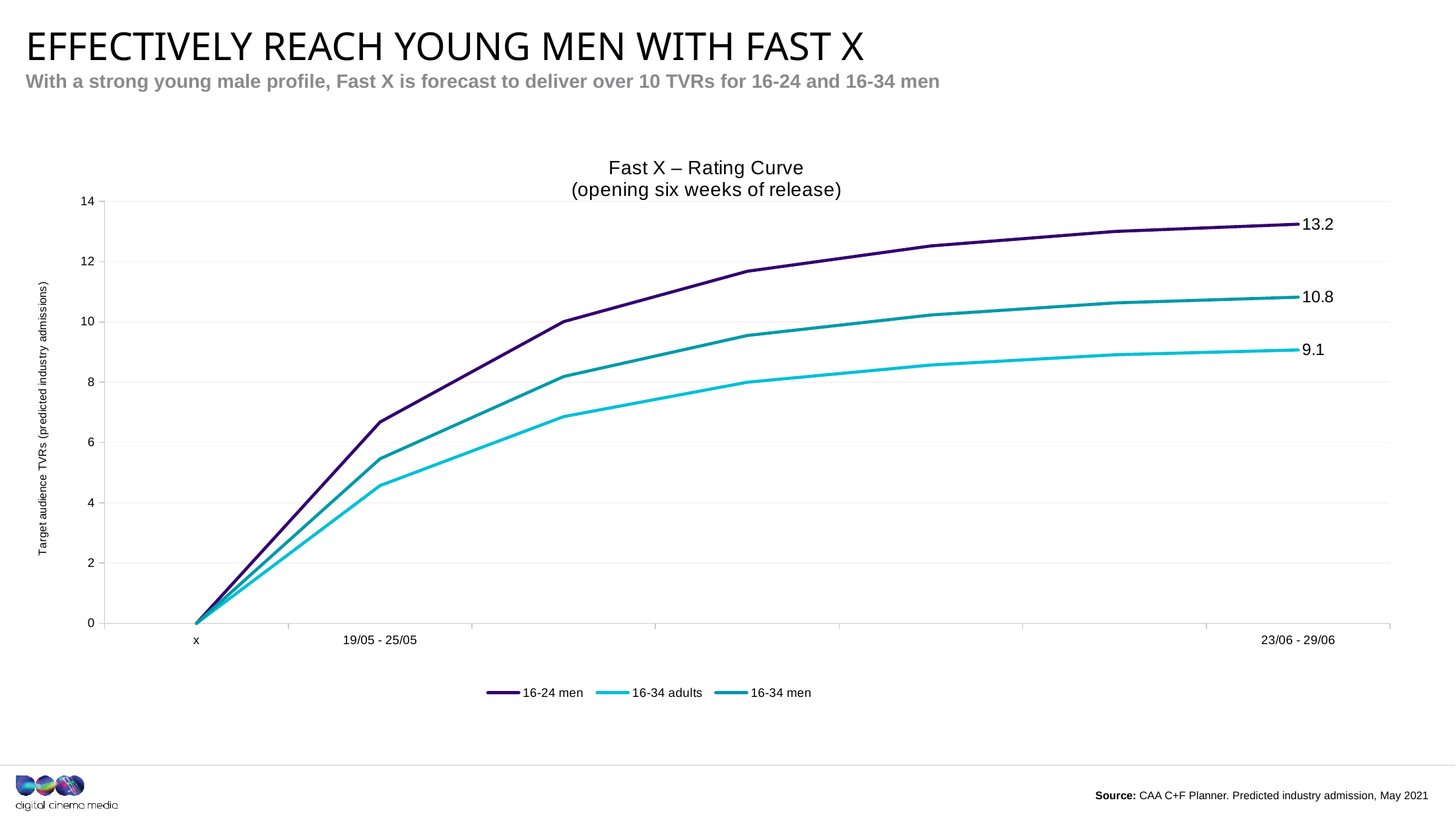
What kind of chart is shown on the slide? line chart What is the final value for 16-24 men at the end of the rating curve? 13.2 At the end of the curve, which is larger: the value for 16-24 men or for 16-34 men? 16-24 men What is the difference between the final values for 16-24 men and 16-34 men? 2.4 Is the value for 16-34 adults in the week 19/05 - 25/05 greater or less than 6? less What is the final value for 16-34 men at the end of the rating curve? 10.8 What is the difference between the final values for 16-34 men and 16-34 adults? 1.7 How many series does the legend list? 3 Do the values for each series rise or fall along the x axis? rise Which series reaches the highest value at the end of the six weeks? 16-24 men Which series has the lowest value at the end of the six weeks? 16-34 adults What is the final value for 16-34 adults at the end of the rating curve? 9.1